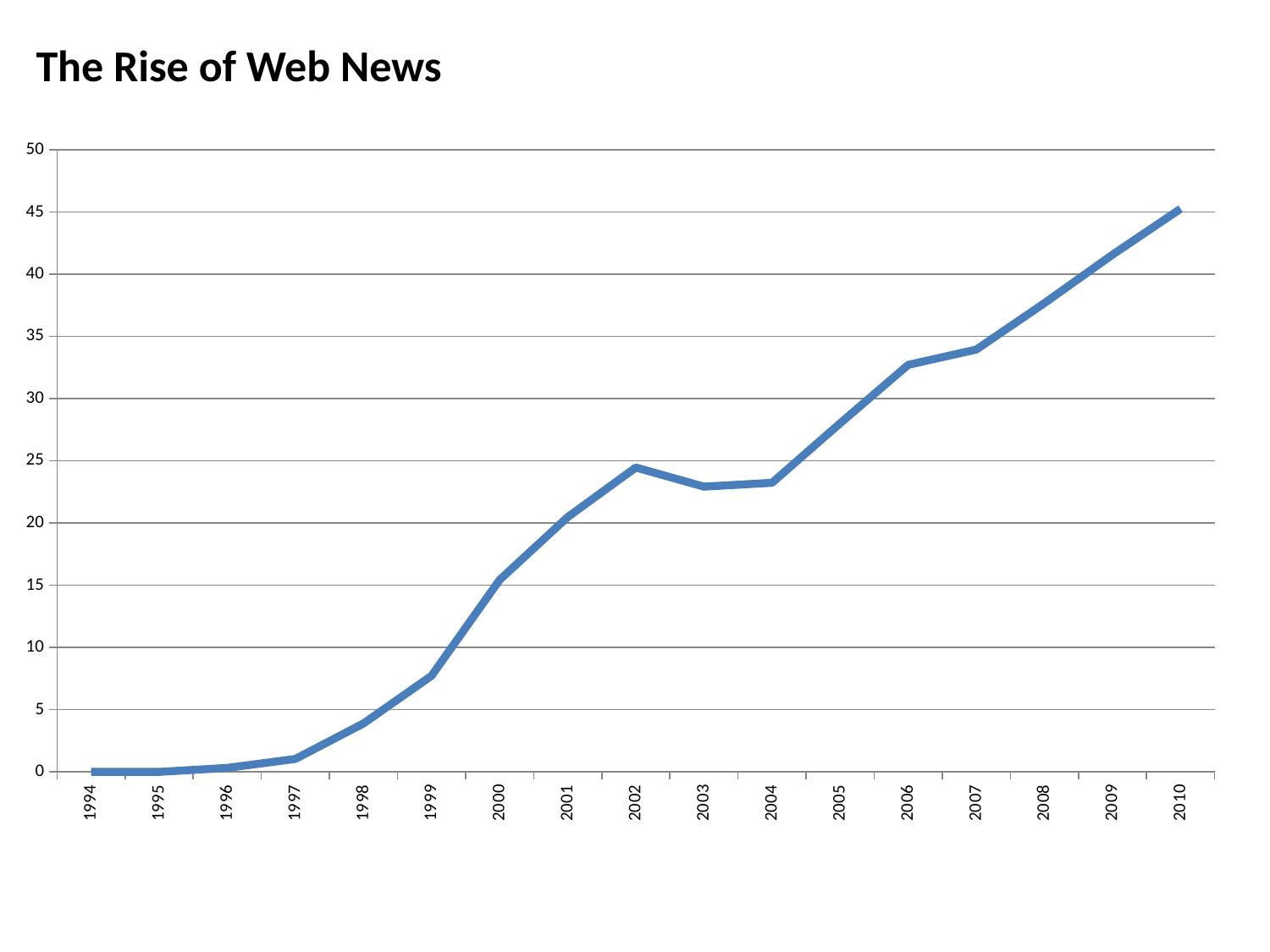
Which is larger, the value for 2002 or the value for 2003? 2002 Is the value for 2008 greater or less than 35? greater Is the value for 2000 greater or less than 10? greater Is the value for 2010 greater or less than 40? greater Overall, do the values rise or fall from 1994 to 2010? rise Which year has the highest value? 2010 How many years are plotted along the x axis? 17 What is the title of the chart on the slide? The Rise of Web News What kind of chart is shown on the slide? line chart